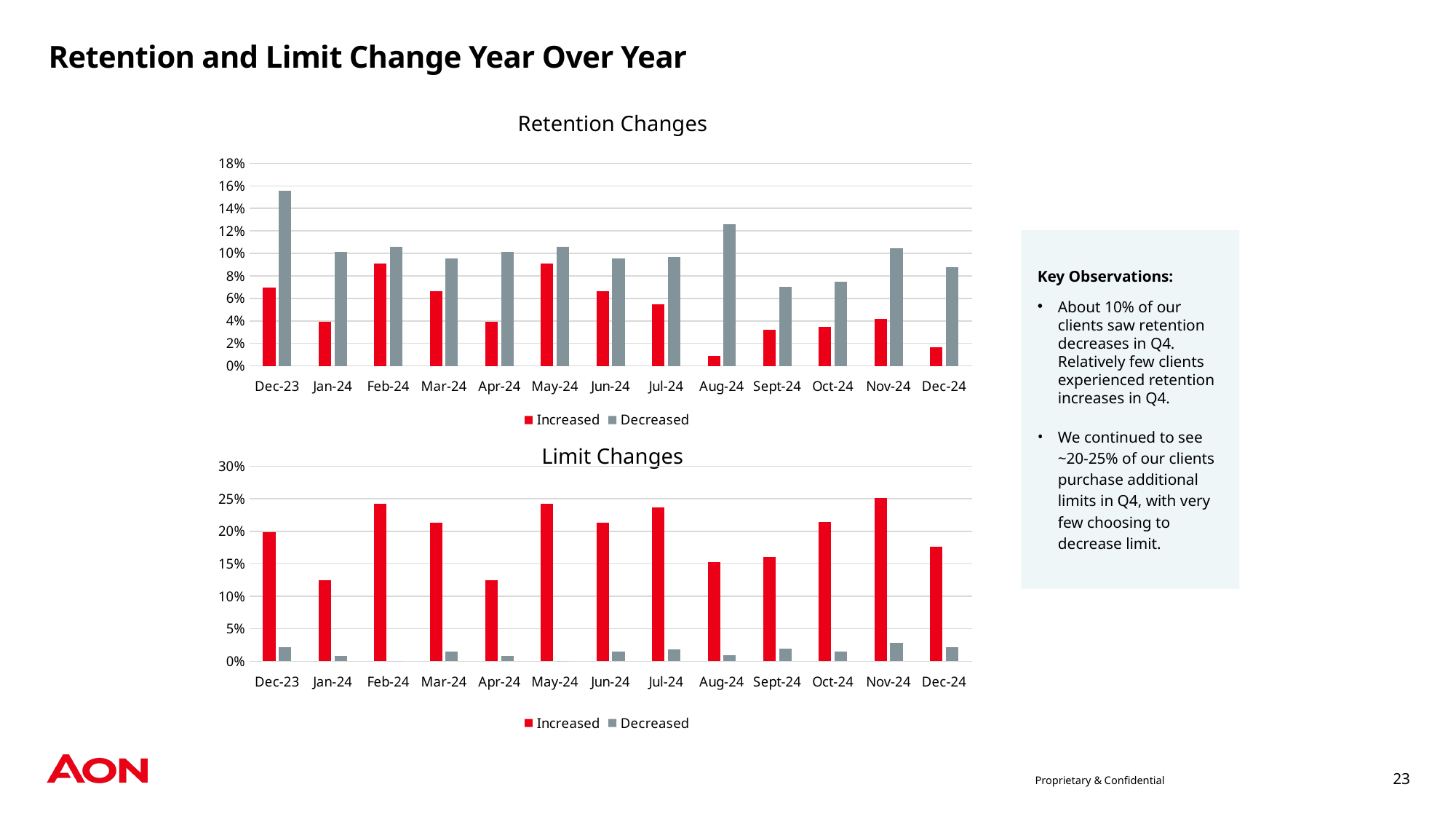
In the Limit Changes chart, do the Increased values rise or fall from Aug-24 to Nov-24? rise In the Limit Changes chart, which month has the highest Increased value? Nov-24 In the Retention Changes chart, is the Decreased value for Dec-23 greater or less than 14%? greater In the Retention Changes chart, which month has the highest Decreased value? Dec-23 In the Limit Changes chart, is the Increased value for Dec-24 greater or less than 20%? less In the Limit Changes chart, which month has the highest Decreased value? Nov-24 What kind of chart is the Retention Changes chart? bar chart In the Retention Changes chart, is the Increased value for Aug-24 greater or less than 2%? less How many series does the legend of the Limit Changes chart list? 2 In the Retention Changes chart, which month has the lowest Increased value? Aug-24 How many months are shown on the x axis of the Retention Changes chart? 13 In the Retention Changes chart, which is larger for Dec-23, the Increased value or the Decreased value? Decreased